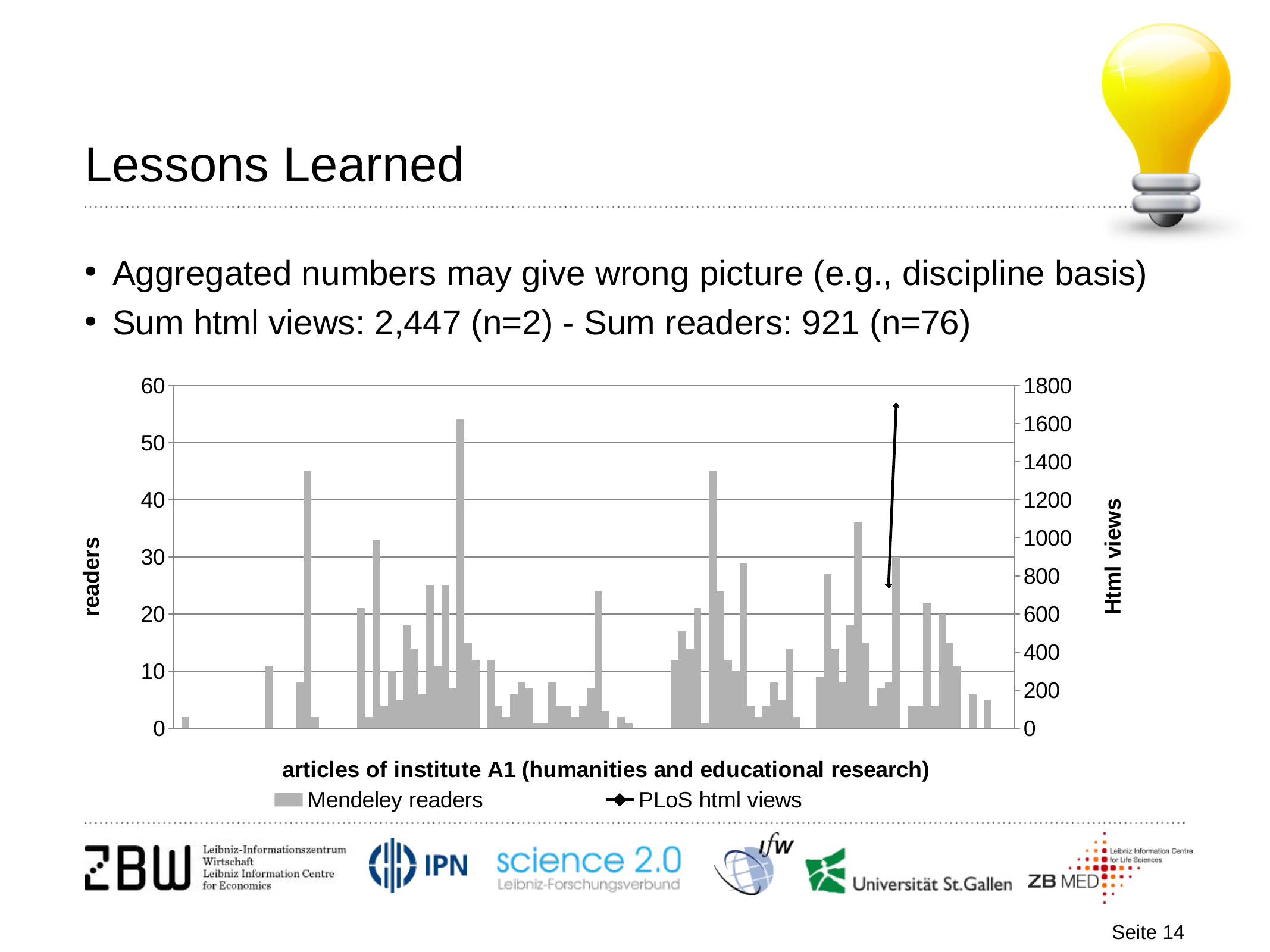
What is the highest tick value shown on the left (readers) axis? 60 Is the tallest Mendeley readers bar greater or less than 50 readers? greater Is the lower PLoS html views point greater or less than 1000 html views? less What is the label of the left vertical axis? readers What is the title of the chart's x axis? articles of institute A1 (humanities and educational research) What is the highest tick value shown on the right (Html views) axis? 1800 How many series does the chart legend list? 2 What are the two series named in the chart legend? Mendeley readers and PLoS html views What is the label of the right vertical axis? Html views How many data points does the PLoS html views series show? 2 What kind of chart is used to show the Mendeley readers series? bar chart Is the higher PLoS html views point greater or less than 1600 html views? greater